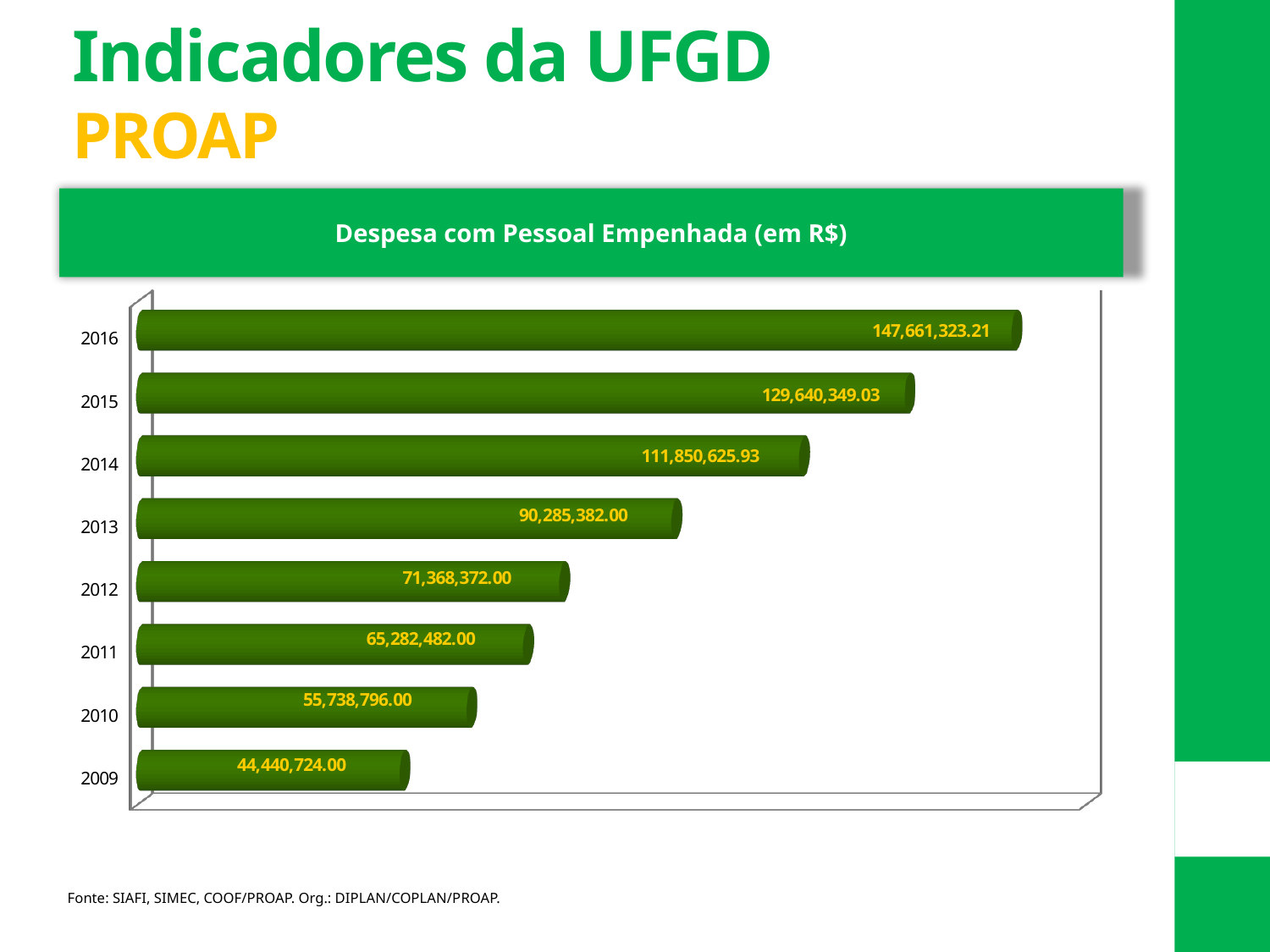
What is the difference between the values for 2016 and 2015? 18,020,974.18 How many years are shown in the chart? 8 What is the value for 2009? 44,440,724.00 What is the value for 2011? 65,282,482.00 Which year has the lowest value? 2009 Which is larger, the value for 2014 or the value for 2012? 2014 What is the difference between the values for 2010 and 2009? 11,298,072.00 Do the values rise or fall from 2009 to 2016? rise What is the value for 2016? 147,661,323.21 Which year has the highest value? 2016 What kind of chart is shown? bar chart What is the value for 2013? 90,285,382.00